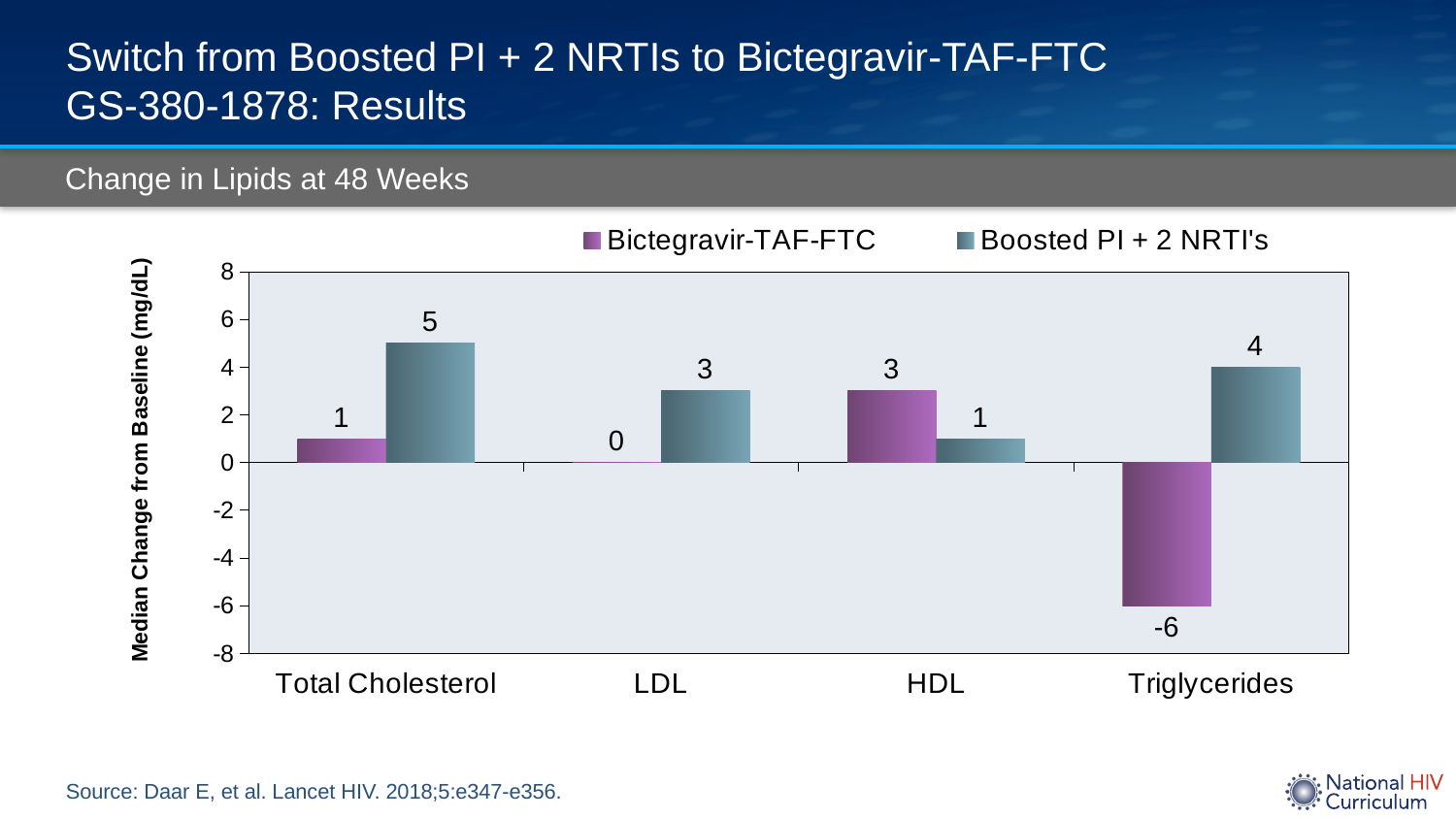
What is the median change from baseline in LDL for Bictegravir-TAF-FTC? 0 What kind of chart is shown on the slide? Bar chart For which lipid category is the Bictegravir-TAF-FTC value lowest? Triglycerides How many series does the legend list? 2 For HDL, which series has the larger median change from baseline? Bictegravir-TAF-FTC What is the difference between the Boosted PI + 2 NRTI's and Bictegravir-TAF-FTC values for Total Cholesterol? 4 What is the median change from baseline in Triglycerides for Boosted PI + 2 NRTI's? 4 What is the difference between the Bictegravir-TAF-FTC and Boosted PI + 2 NRTI's values for Triglycerides? 10 What is the median change from baseline in Total Cholesterol for Bictegravir-TAF-FTC? 1 How many lipid categories are shown on the x axis? 4 What is the median change from baseline in HDL for Boosted PI + 2 NRTI's? 1 For which lipid category is the Boosted PI + 2 NRTI's value highest? Total Cholesterol